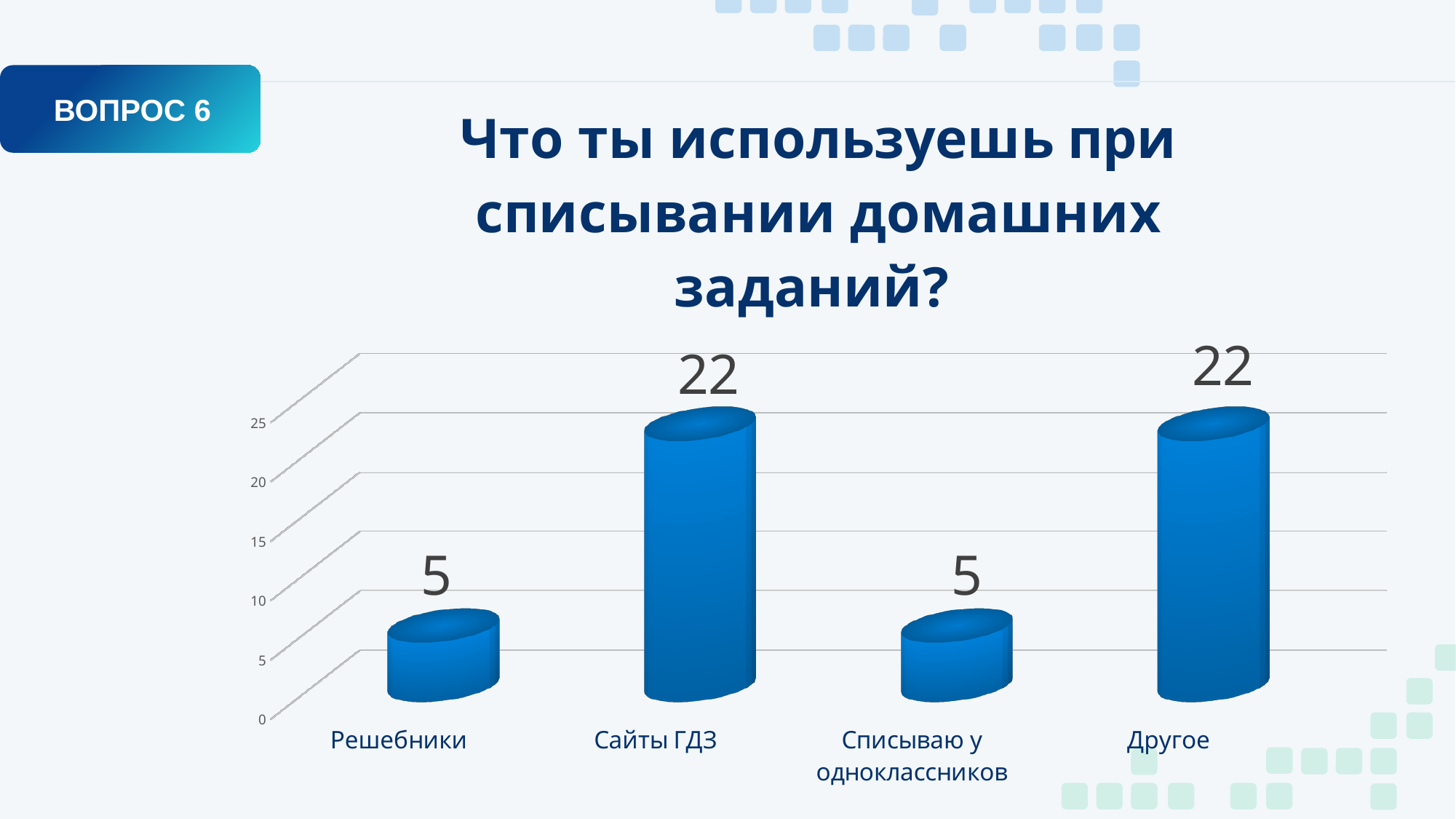
How many categories are shown on the chart? 4 Which is larger, the value for Сайты ГДЗ or the value for Решебники? Сайты ГДЗ What is the difference between the values for Другое and Списываю у одноклассников? 17 What is the value for Сайты ГДЗ? 22 What is the value for Другое? 22 Which is larger, the value for Списываю у одноклассников or the value for Другое? Другое Is the value for Решебники greater or less than 10? less What is the difference between the values for Сайты ГДЗ and Решебники? 17 What is the value for Решебники? 5 Is the value for Сайты ГДЗ greater or less than 20? greater What is the value for Списываю у одноклассников? 5 What kind of chart is shown on the slide? bar chart